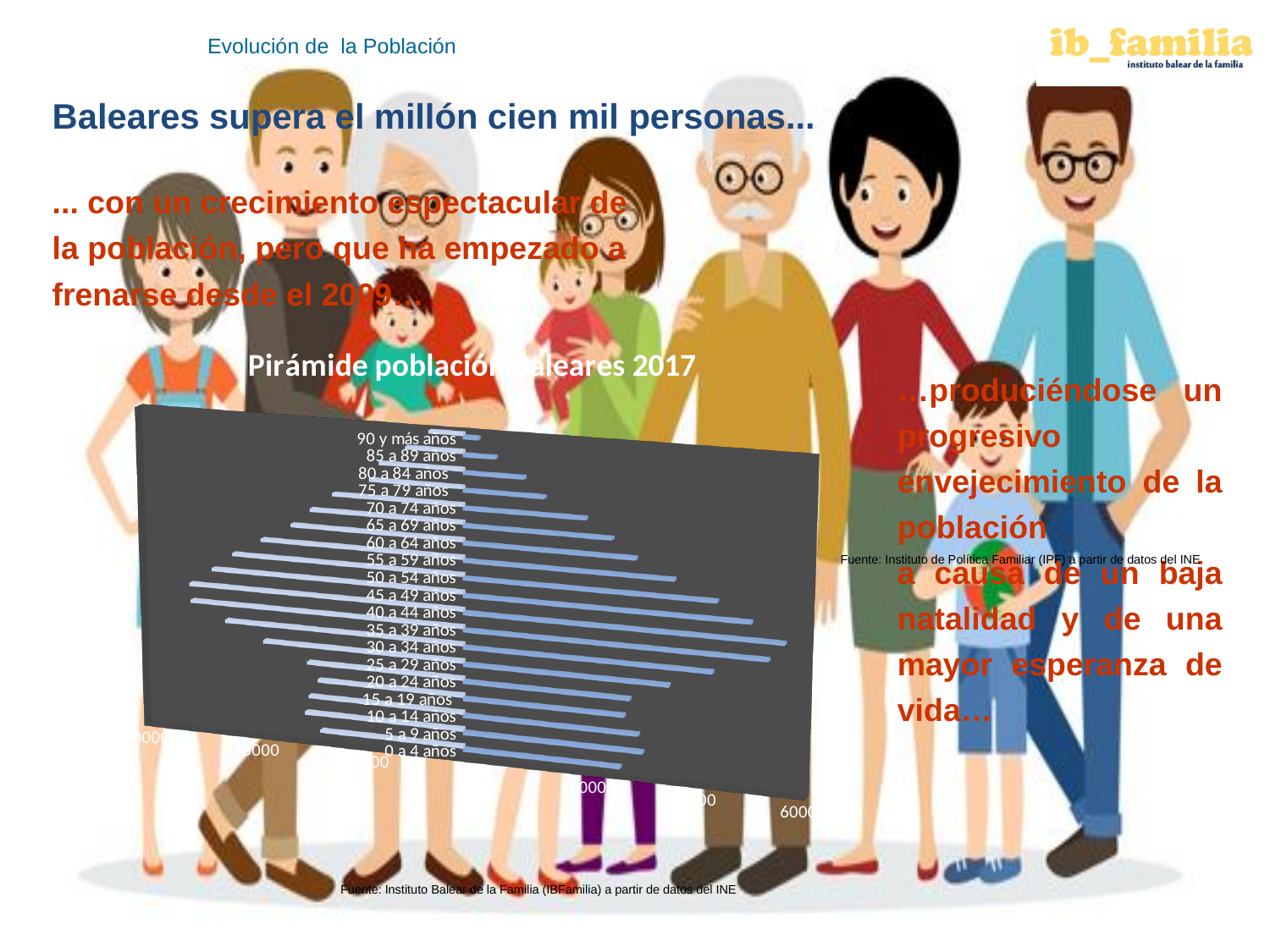
Which age group has longer bars, 45 a 49 años or 80 a 84 años? 45 a 49 años Which age group has longer bars, 40 a 44 años or 90 y más años? 40 a 44 años Which age group is listed at the top of the pyramid's vertical axis? 90 y más años What is the title of the chart on the slide? Pirámide población Baleares 2017 Which age group has the shortest bars in the population pyramid? 90 y más años Do the bars get longer or shorter as the age groups go from 40 a 44 años up to 90 y más años? Shorter Which age group has the longest bars in the population pyramid? 40 a 44 años What kind of chart is shown under the title 'Pirámide población Baleares 2017'? Bar chart Which age group has longer bars, 40 a 44 años or 70 a 74 años? 40 a 44 años How many age groups are listed on the chart's vertical axis? 19